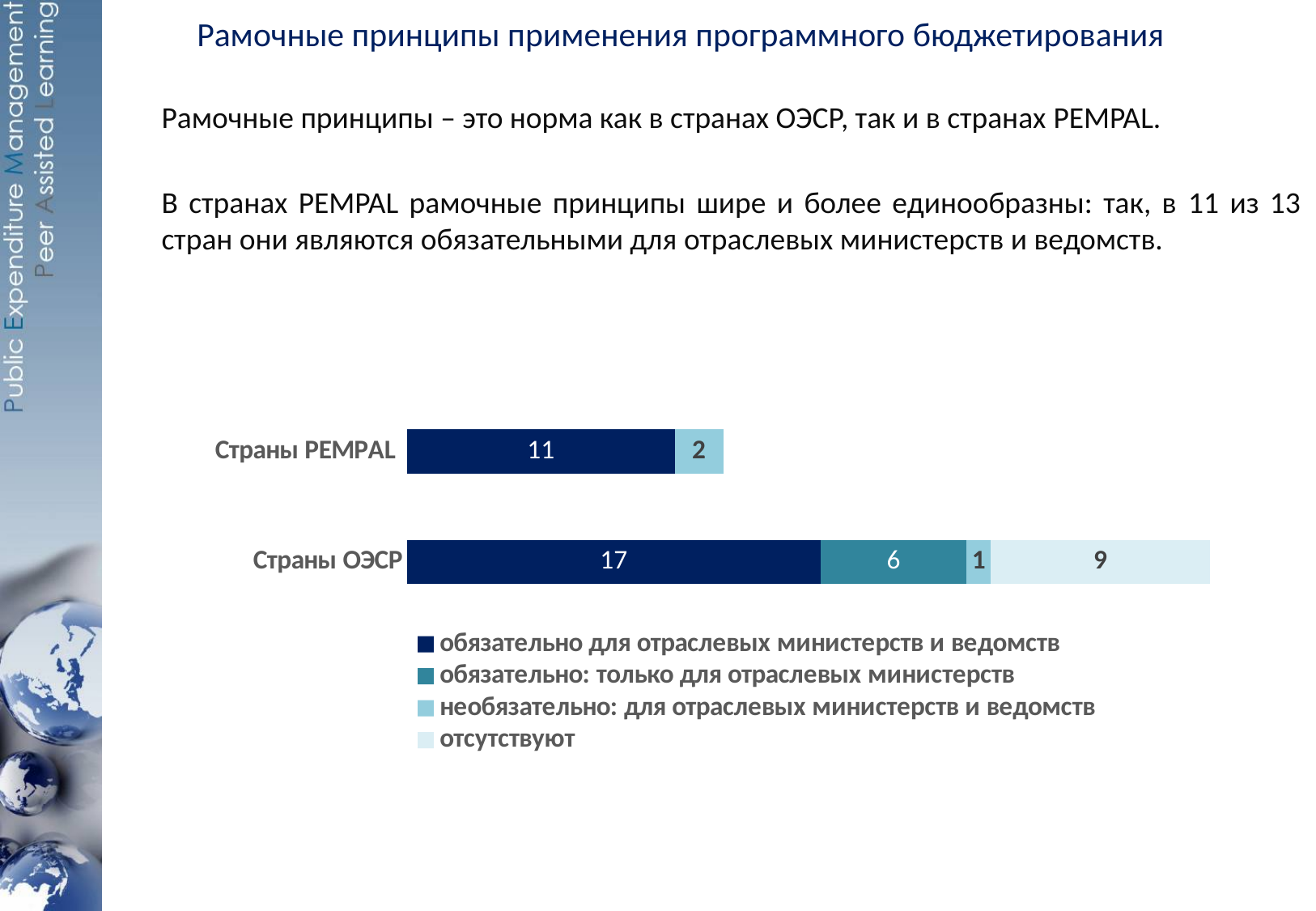
Какова общая сумма значений в столбце «Страны PEMPAL»? 13 На сколько значение «обязательно для отраслевых министерств и ведомств» для стран ОЭСР больше, чем для стран PEMPAL? 6 Какой тип диаграммы показан на слайде? Столбчатая (линейчатая) диаграмма с накоплением Каково значение «отсутствуют» для стран ОЭСР? 9 Каково значение «обязательно для отраслевых министерств и ведомств» для стран PEMPAL? 11 Каково значение «обязательно для отраслевых министерств и ведомств» для стран ОЭСР? 17 Какова общая сумма значений в столбце «Страны ОЭСР»? 33 Какой ряд данных в легенде обозначен самым светлым цветом? отсутствуют Сколько рядов данных перечислено в легенде диаграммы? 4 Сколько категорий (стран/групп) показано на диаграмме? 2 Каково значение «необязательно: для отраслевых министерств и ведомств» для стран PEMPAL? 2 Каково значение «обязательно: только для отраслевых министерств» для стран ОЭСР? 6